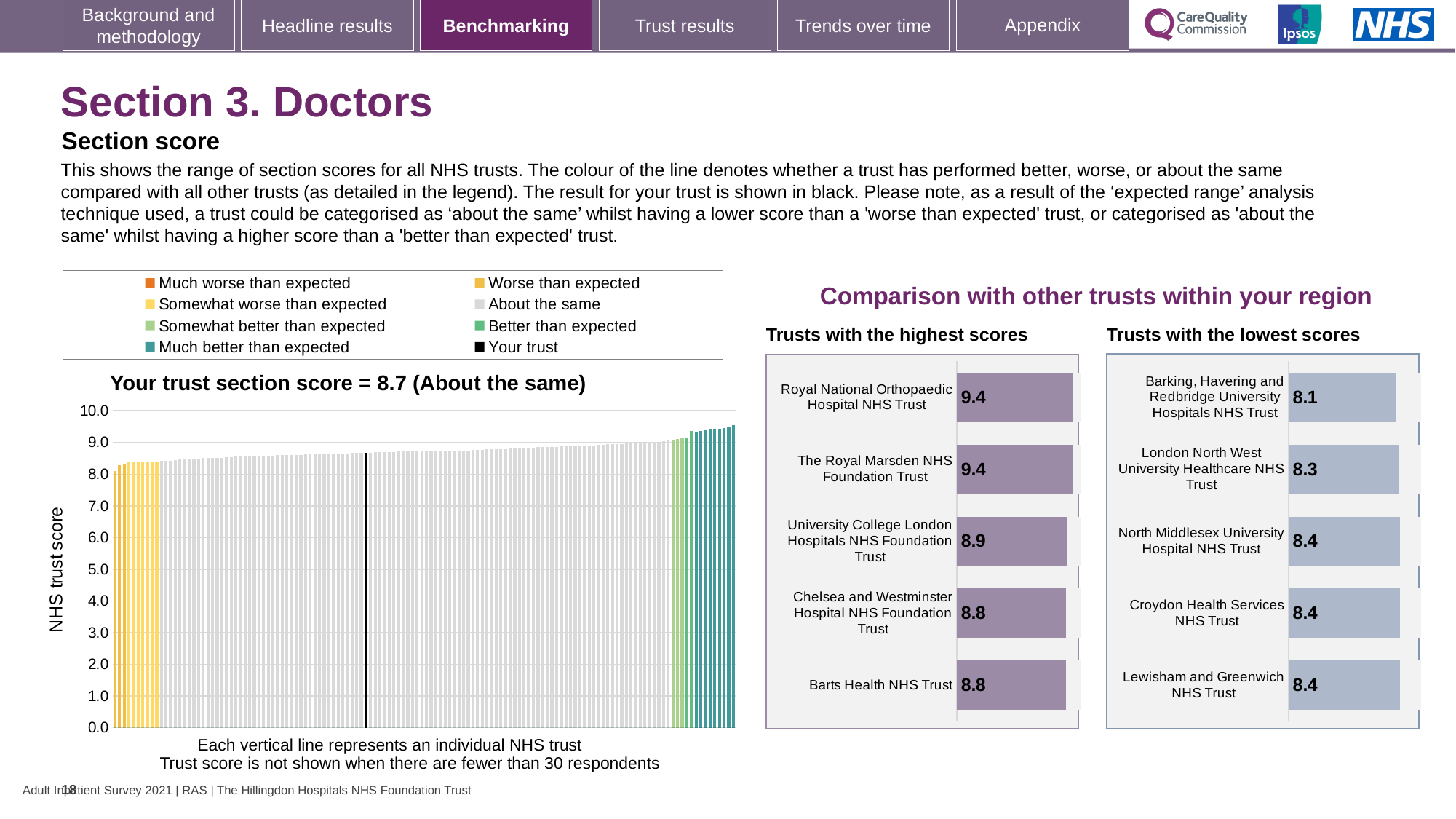
On the 'Trusts with the highest scores' chart, what is the score for University College London Hospitals NHS Foundation Trust? 8.9 On the 'Trusts with the highest scores' chart, what is the difference between the scores of Royal National Orthopaedic Hospital NHS Trust and Barts Health NHS Trust? 0.6 On the 'Trusts with the highest scores' chart, how many trusts are listed? 5 On the 'Your trust section score' chart, what kind of chart is shown? bar chart On the 'Trusts with the lowest scores' chart, what is the score for London North West University Healthcare NHS Trust? 8.3 On the 'Trusts with the highest scores' chart, which has the higher score: University College London Hospitals NHS Foundation Trust or Chelsea and Westminster Hospital NHS Foundation Trust? University College London Hospitals NHS Foundation Trust On the 'Your trust section score' chart, is the value of the tallest bar greater or less than 9.0? greater On the 'Your trust section score' chart, what is the label on the vertical axis? NHS trust score On the 'Your trust section score' chart, how many entries does the legend list? 8 On the 'Your trust section score' chart, what is the section score for your trust? 8.7 On the 'Trusts with the lowest scores' chart, what is the difference between the scores of Lewisham and Greenwich NHS Trust and Barking, Havering and Redbridge University Hospitals NHS Trust? 0.3 On the 'Trusts with the lowest scores' chart, which trust has the lowest score? Barking, Havering and Redbridge University Hospitals NHS Trust